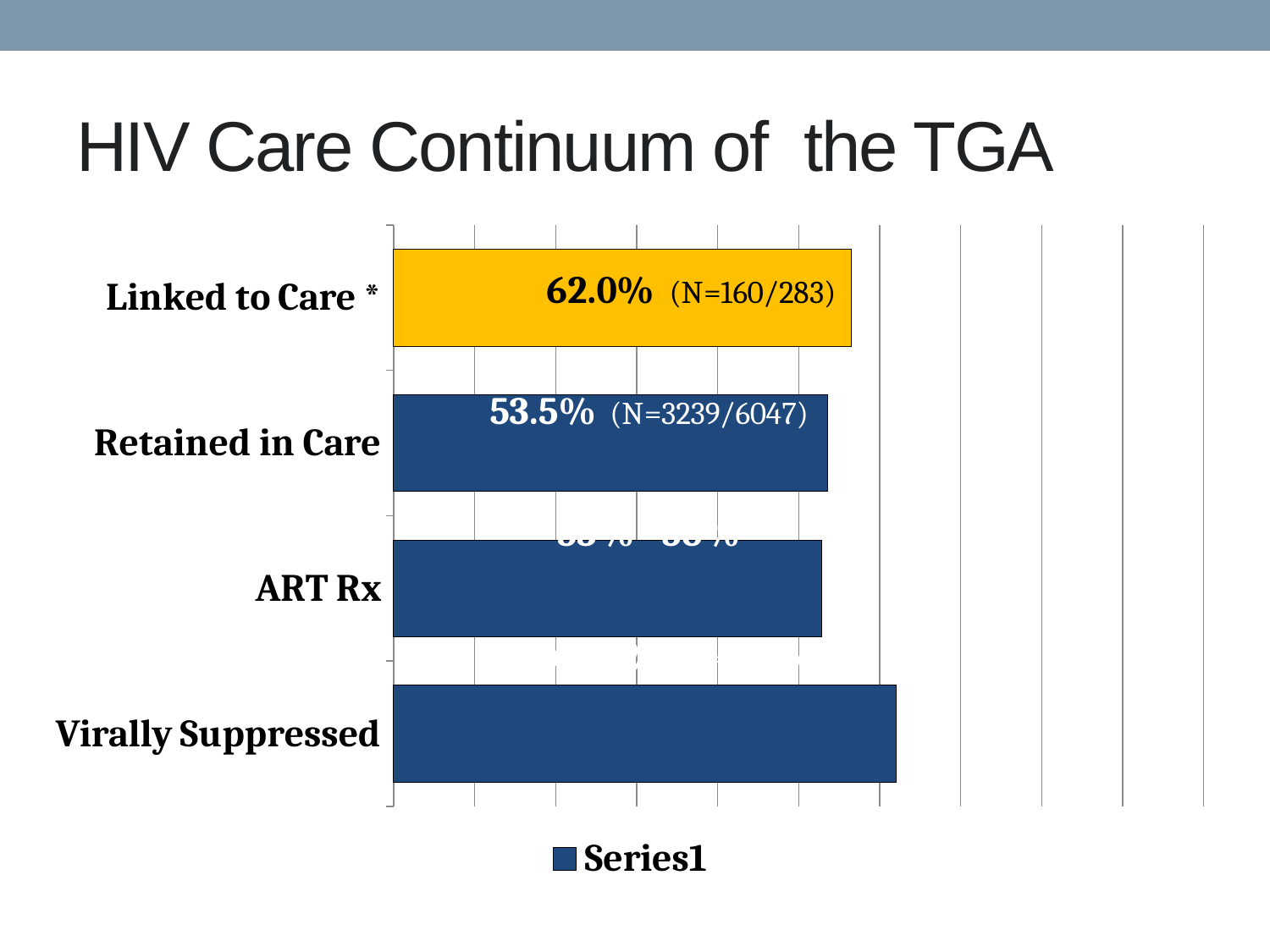
What is the name of the series shown in the legend? Series1 Which category has the longest bar in the chart? Virally Suppressed What is the difference in percentage points between Linked to Care * and Retained in Care? 8.5 percentage points Which category's bar is coloured differently (yellow) from the others? Linked to Care * What N fraction is printed next to the Retained in Care bar? N=3239/6047 How many series does the legend list? 1 What is the value shown for Linked to Care *? 62.0% What kind of chart is shown on the slide? Bar chart Which is larger, the value for Linked to Care * or the value for Retained in Care? Linked to Care * What N fraction is printed next to the Linked to Care * bar? N=160/283 What is the value shown for Retained in Care? 53.5% How many categories are shown in the chart? 4